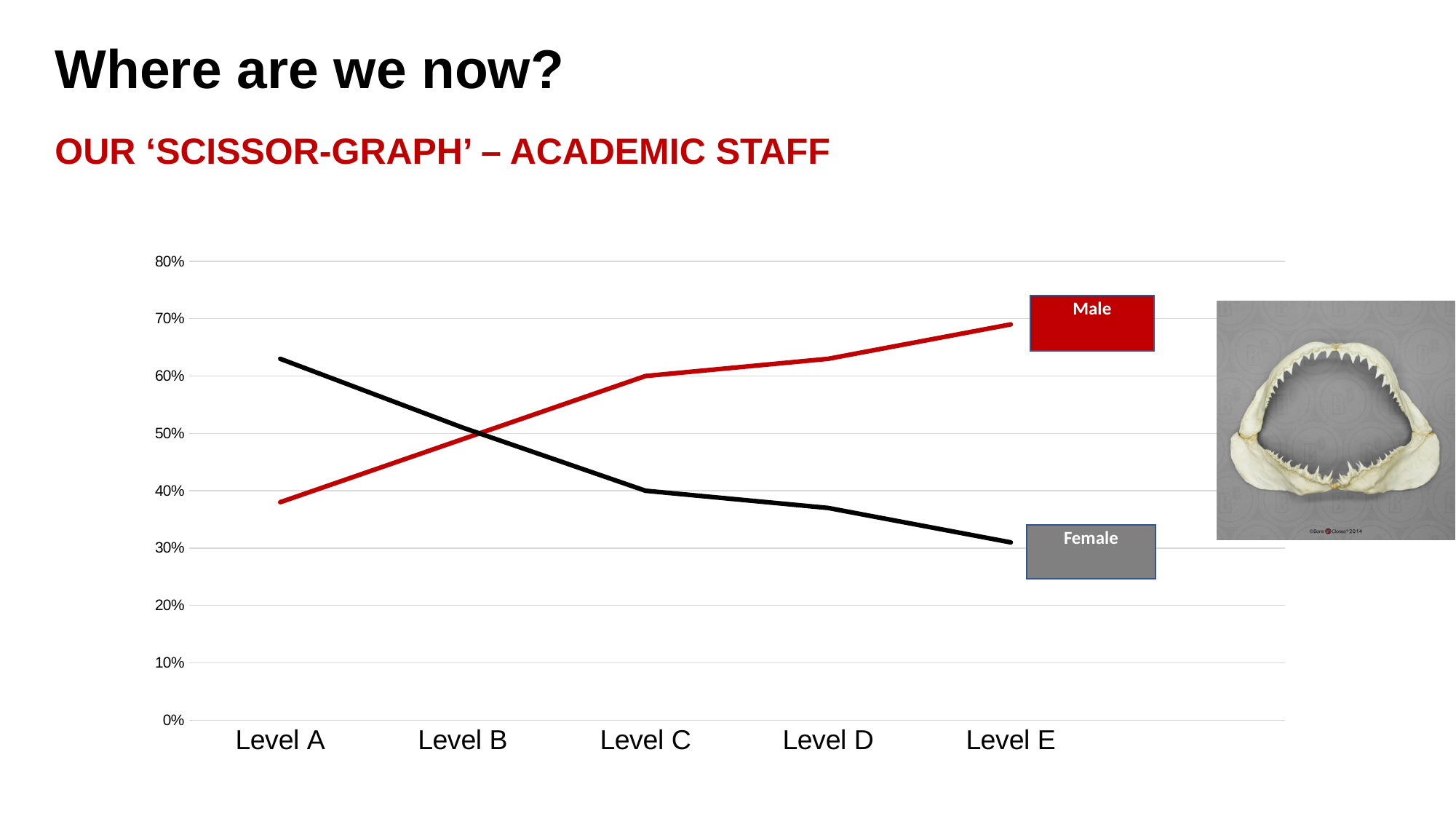
At Level E, which series has the higher value, Male or Female? Male Is the Female value at Level A greater or less than 60%? greater Is the Male value at Level A greater or less than 40%? less Does the Male line rise or fall from Level A to Level E? rise Does the Female line rise or fall from Level A to Level E? fall Is the Male value at Level E greater or less than 60%? greater How many series does the chart's legend list? 2 What kind of chart is shown on the slide? line chart What colour is the Male line in the chart? red How many levels are shown on the x axis of the chart? 5 At Level A, which series has the higher value, Male or Female? Female